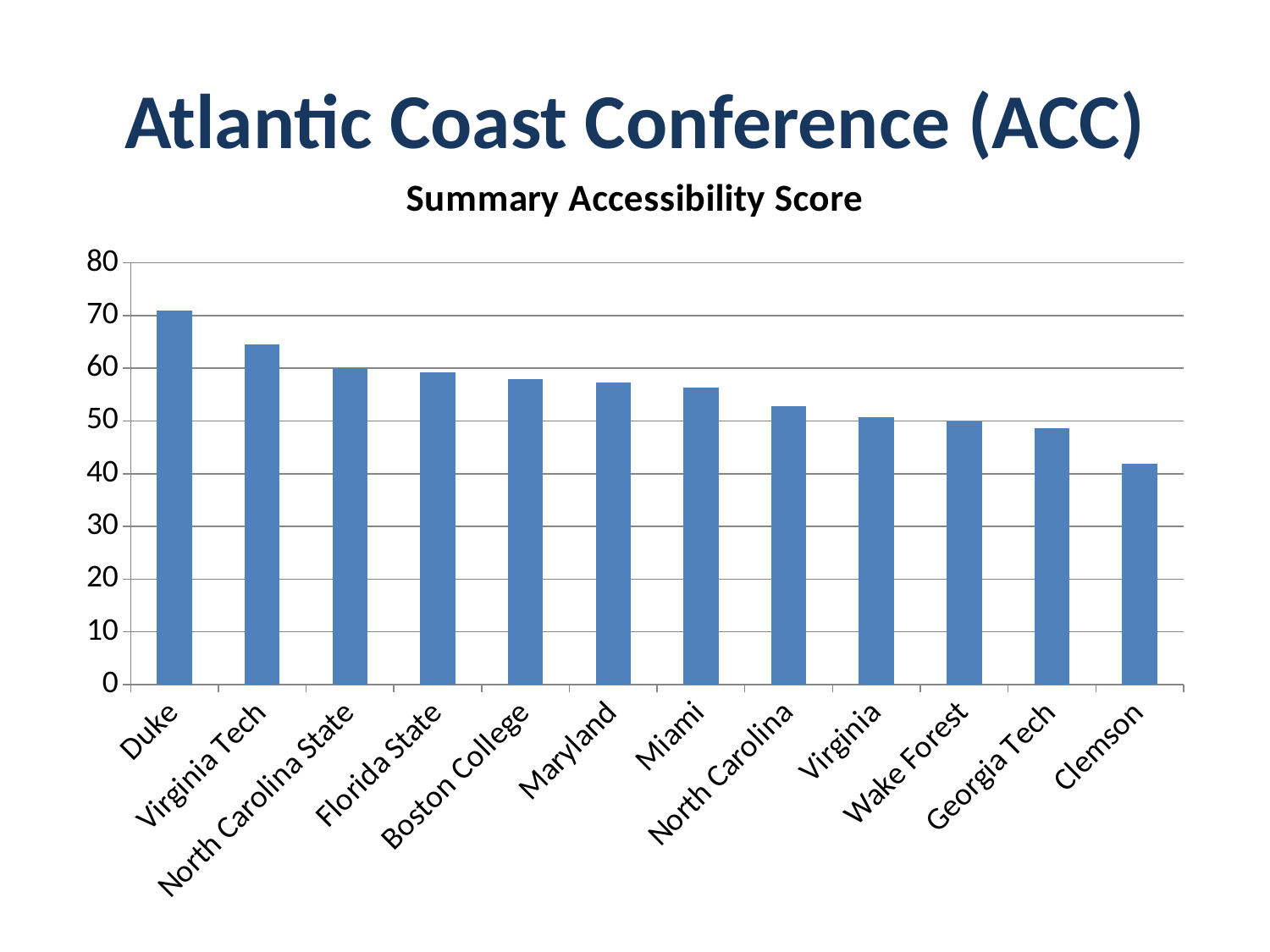
Do the values rise or fall moving from left to right along the x axis? fall Is the value for Georgia Tech greater or less than 50? less Which school has the highest Summary Accessibility Score? Duke Is the value for Duke greater or less than 60? greater How many schools are shown on the chart? 12 What kind of chart is shown on the slide? bar chart Is the value for Miami greater or less than 60? less Which school has the lowest Summary Accessibility Score? Clemson What is the title of the chart? Summary Accessibility Score Which has the larger value, Virginia Tech or Miami? Virginia Tech Which has the larger value, Maryland or North Carolina? Maryland